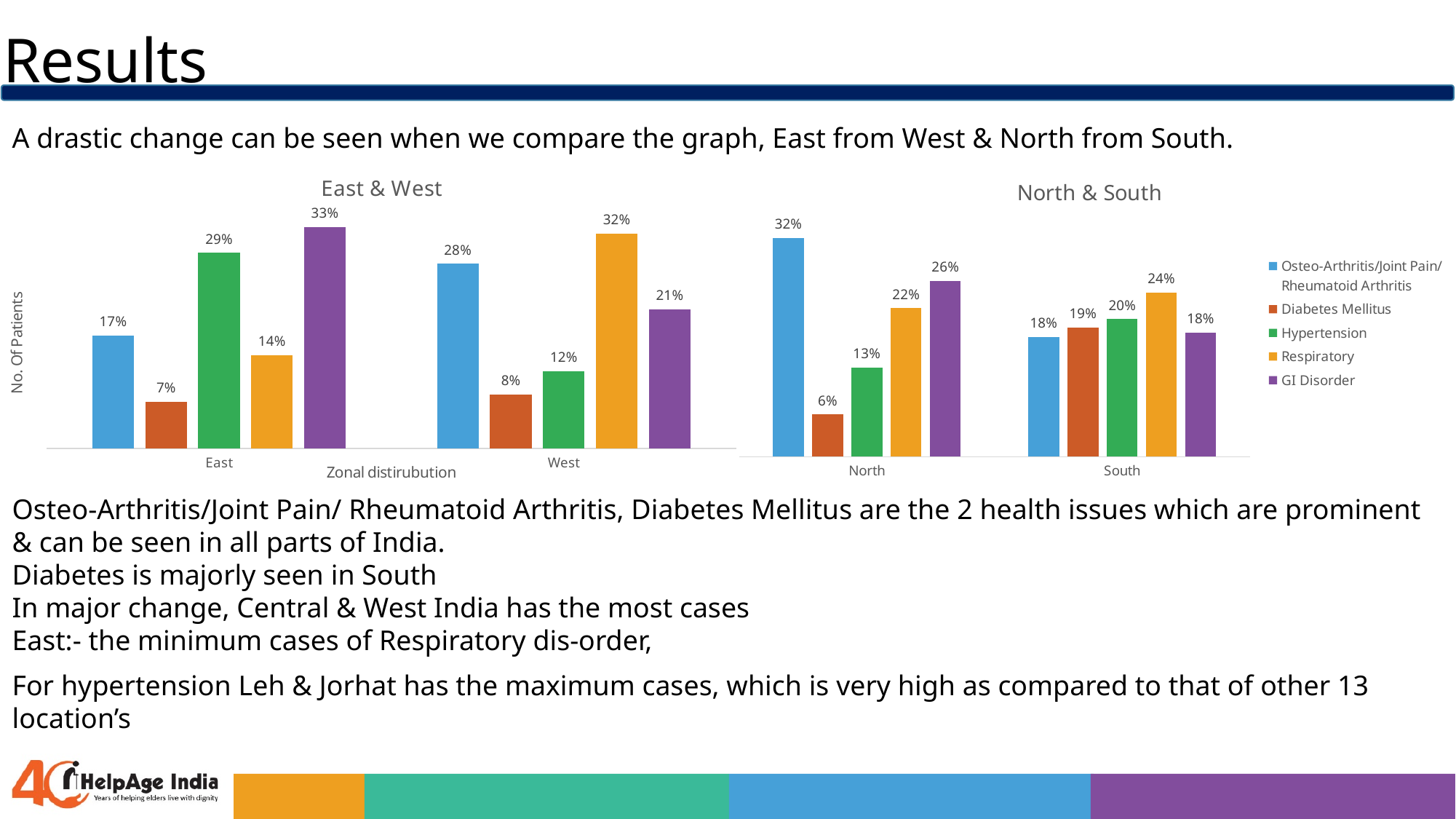
What kind of chart is the North & South chart? Bar chart In the North & South chart, which series has the lowest value in North? Diabetes Mellitus In the East & West chart, which series has the highest value in East? GI Disorder How many series does the legend list? 5 In the East & West chart, what is the difference between Hypertension in East and Hypertension in West? 17% In the North & South chart, which is larger: Osteo-Arthritis/Joint Pain/Rheumatoid Arthritis in North or in South? North In the East & West chart, what is the value for Hypertension in East? 29% In the North & South chart, what is the value for Respiratory in South? 24% What is the title of the chart on the left? East & West In the East & West chart, what is the value for Respiratory in West? 32% In the East & West chart, what is the difference between the GI Disorder values for East and West? 12% In the North & South chart, what is the value for Diabetes Mellitus in North? 6%